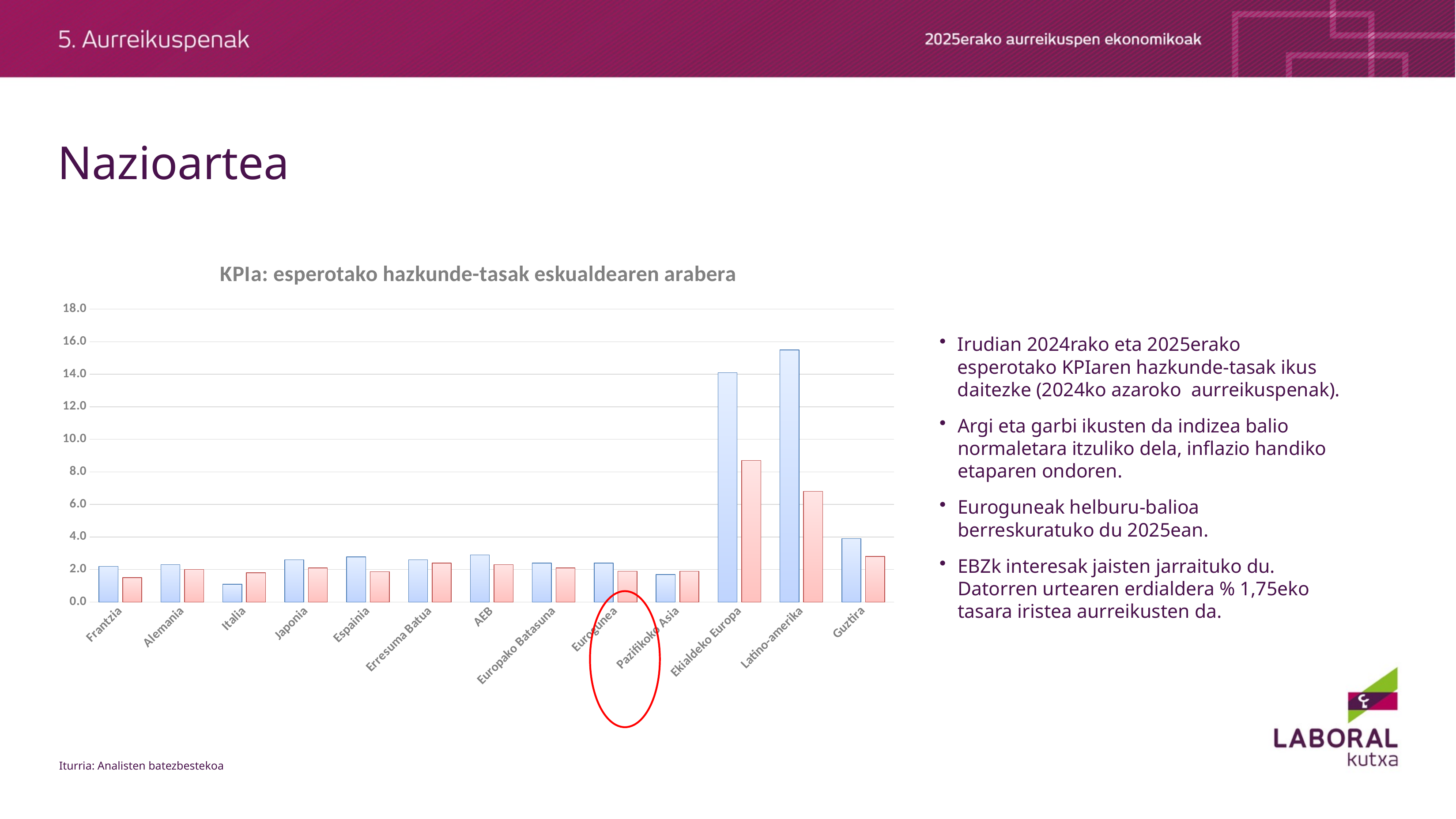
Which category has the tallest blue bar? Latino-amerika Which category has the shortest blue bar? Italia Is the red bar for Frantzia greater or less than 2.0? less Is the blue bar for Ekialdeko Europa greater or less than 12.0? greater Is the blue bar for Italia greater or less than 2.0? less How many categories are shown on the x axis of the chart? 13 What is the title of the chart? KPIa: esperotako hazkunde-tasak eskualdearen arabera For Ekialdeko Europa, which bar is taller, the blue one or the red one? the blue one What kind of chart is shown on the slide? bar chart Which category has the tallest red bar? Ekialdeko Europa For Italia, which bar is taller, the blue one or the red one? the red one